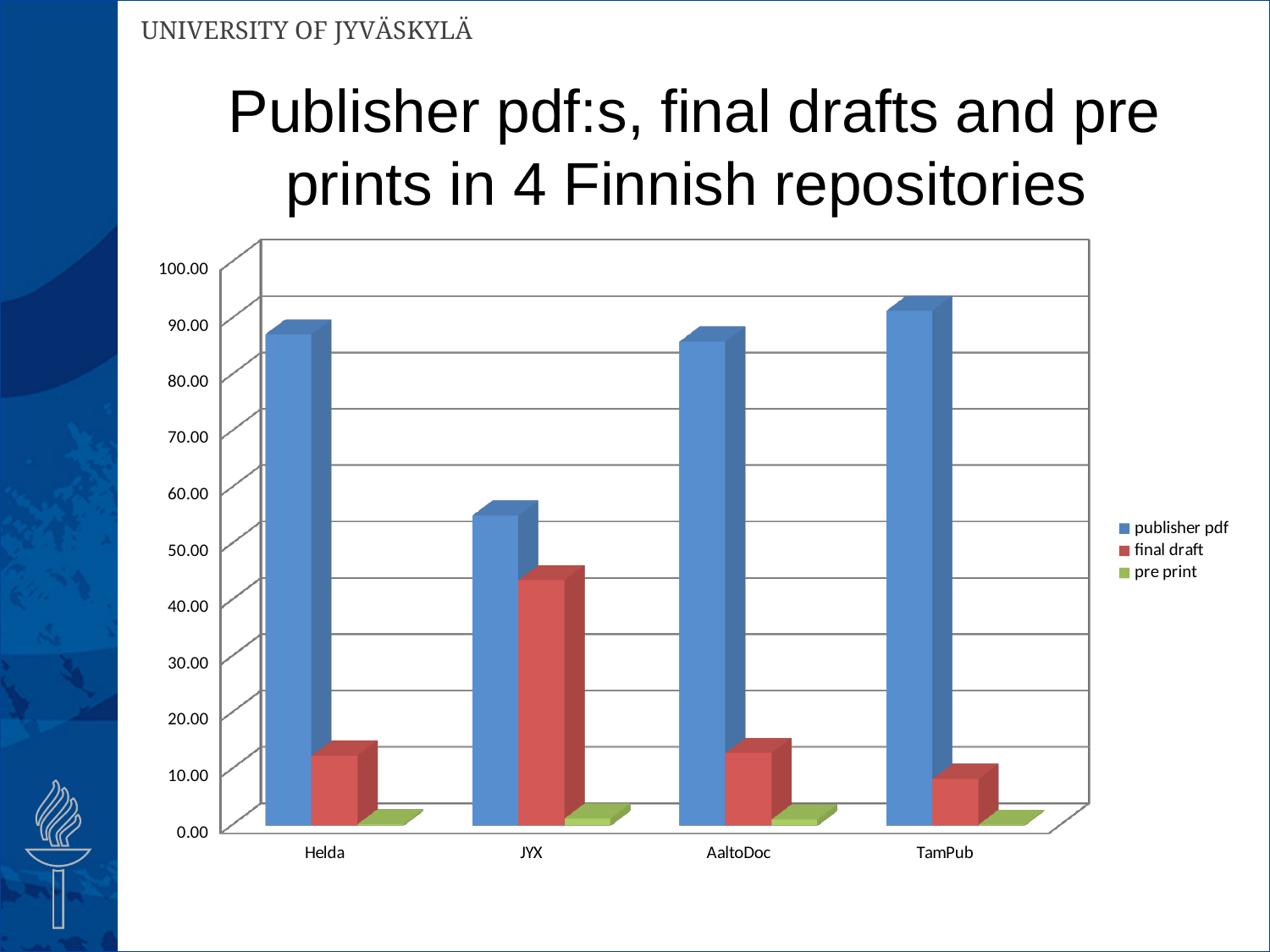
Is the publisher pdf value for Helda greater or less than 80? greater How many repositories (categories) are shown on the x axis? 4 Is the final draft value for TamPub greater or less than 20? less How many series does the legend list? 3 Which repository has the lowest final draft value? TamPub Which is larger for JYX: the publisher pdf value or the final draft value? publisher pdf What kind of chart is shown on the slide? bar chart Which repository has the highest final draft value? JYX Which series is shown in green in the legend? pre print Which repository has the highest publisher pdf value? TamPub Which repository has the lowest publisher pdf value? JYX Is the publisher pdf value for JYX greater or less than 60? less